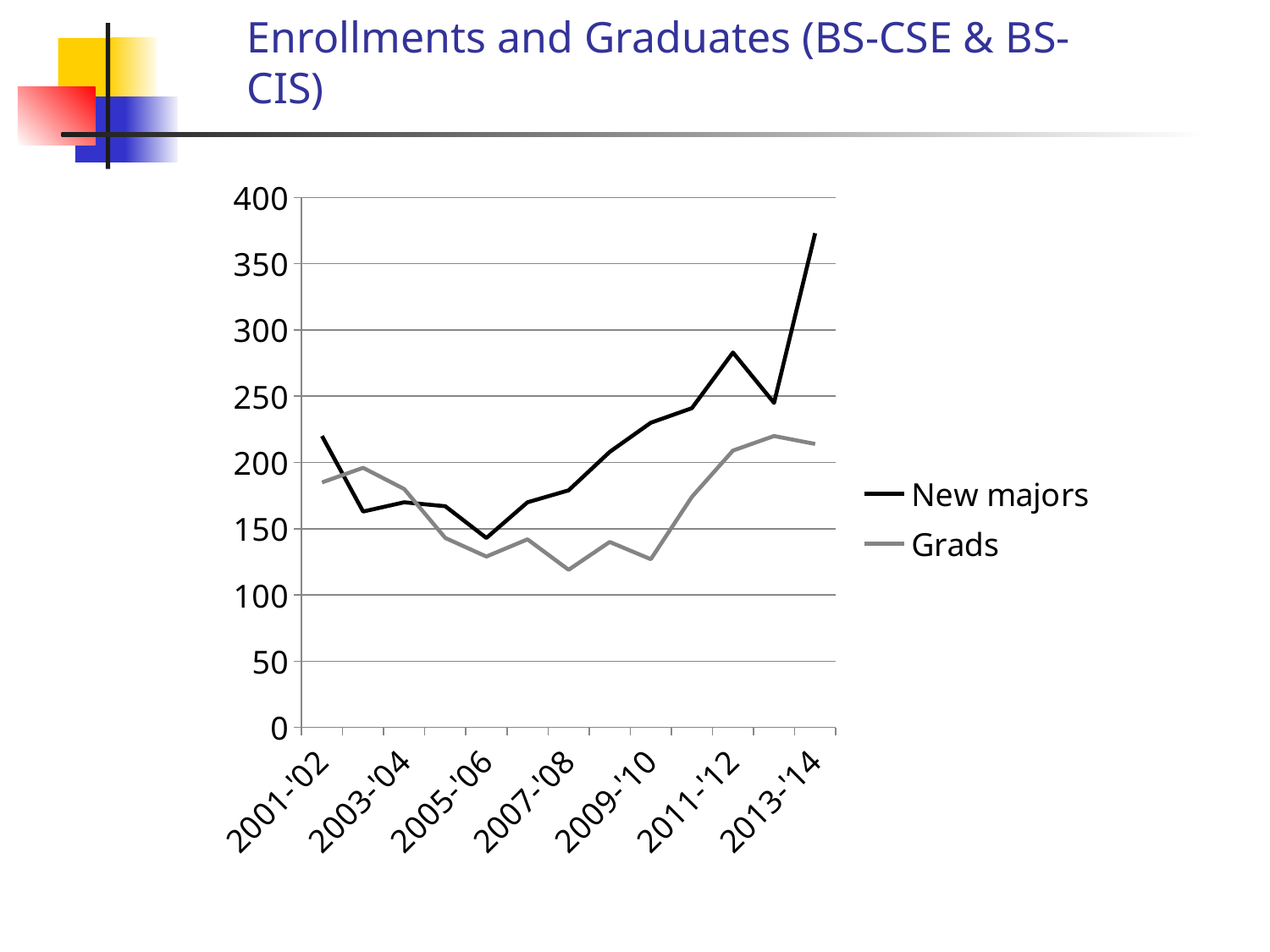
Is the New majors value for 2013-'14 greater or less than 350? greater In 2011-'12, which series has the larger value, New majors or Grads? New majors What is the title of the chart? Enrollments and Graduates (BS-CSE & BS-CIS) Is the New majors value for 2011-'12 greater or less than 250? greater Does the New majors line rise or fall from 2009-'10 to 2011-'12? rise What are the two series named in the legend? New majors and Grads How many series does the legend list? 2 Is the Grads value for 2005-'06 greater or less than 150? less In which year is the New majors value lowest? 2005-'06 What kind of chart is shown on the slide? line chart In which year is the Grads value lowest? 2007-'08 In which year is the New majors value highest? 2013-'14